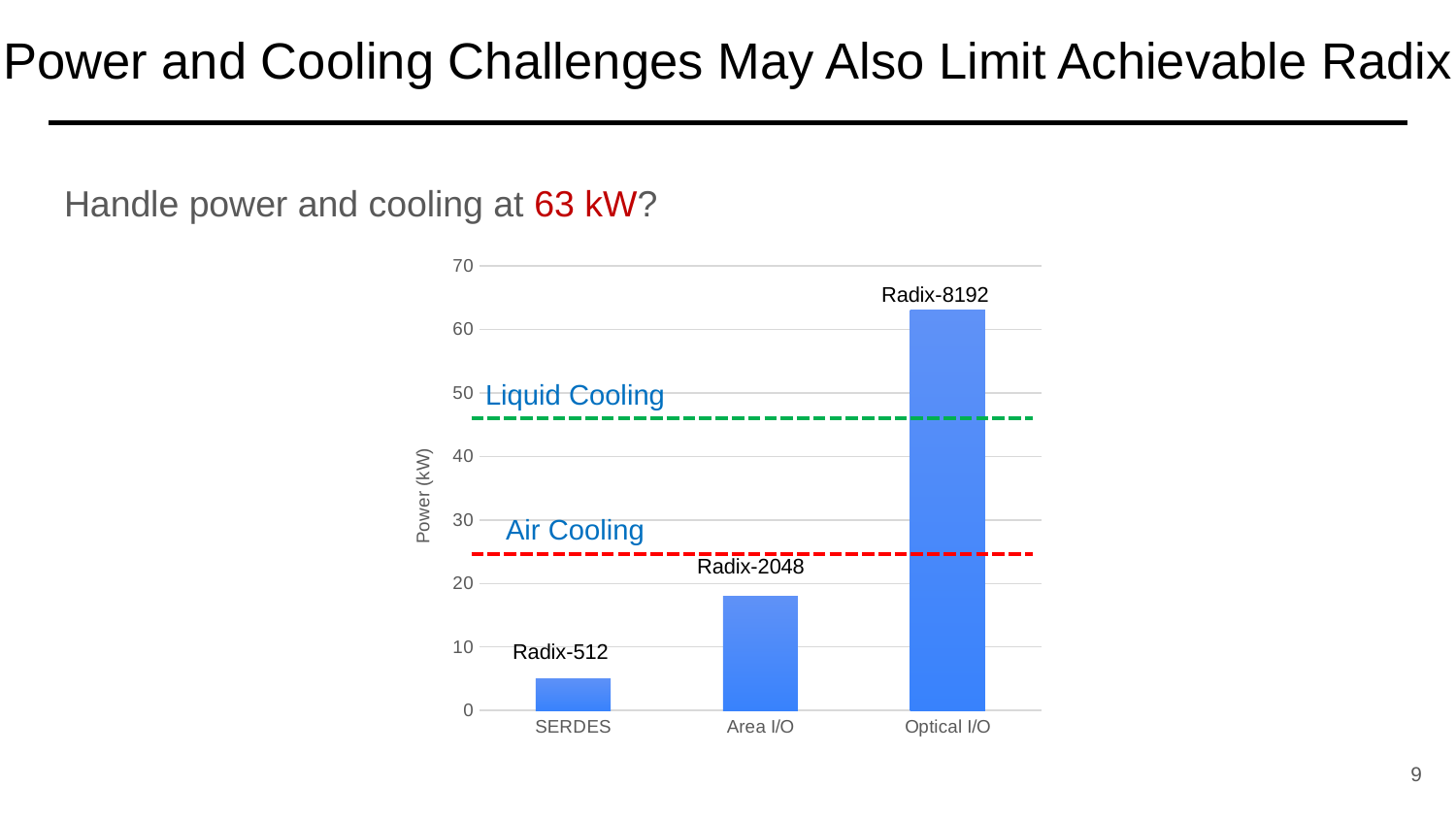
Which category has the highest power value? Optical I/O How many categories are shown on the x axis of the chart? 3 What label appears above the Optical I/O bar? Radix-8192 What is the label on the y axis of the chart? Power (kW) Is the value for Area I/O greater or less than 30? less Is the value for Area I/O greater or less than 10? greater Is the value for SERDES greater or less than 10? less Which category has the lowest power value? SERDES Which has the larger power value, Area I/O or SERDES? Area I/O What kind of chart is shown on the slide? bar chart Do the bar values rise or fall from left to right along the x axis? rise